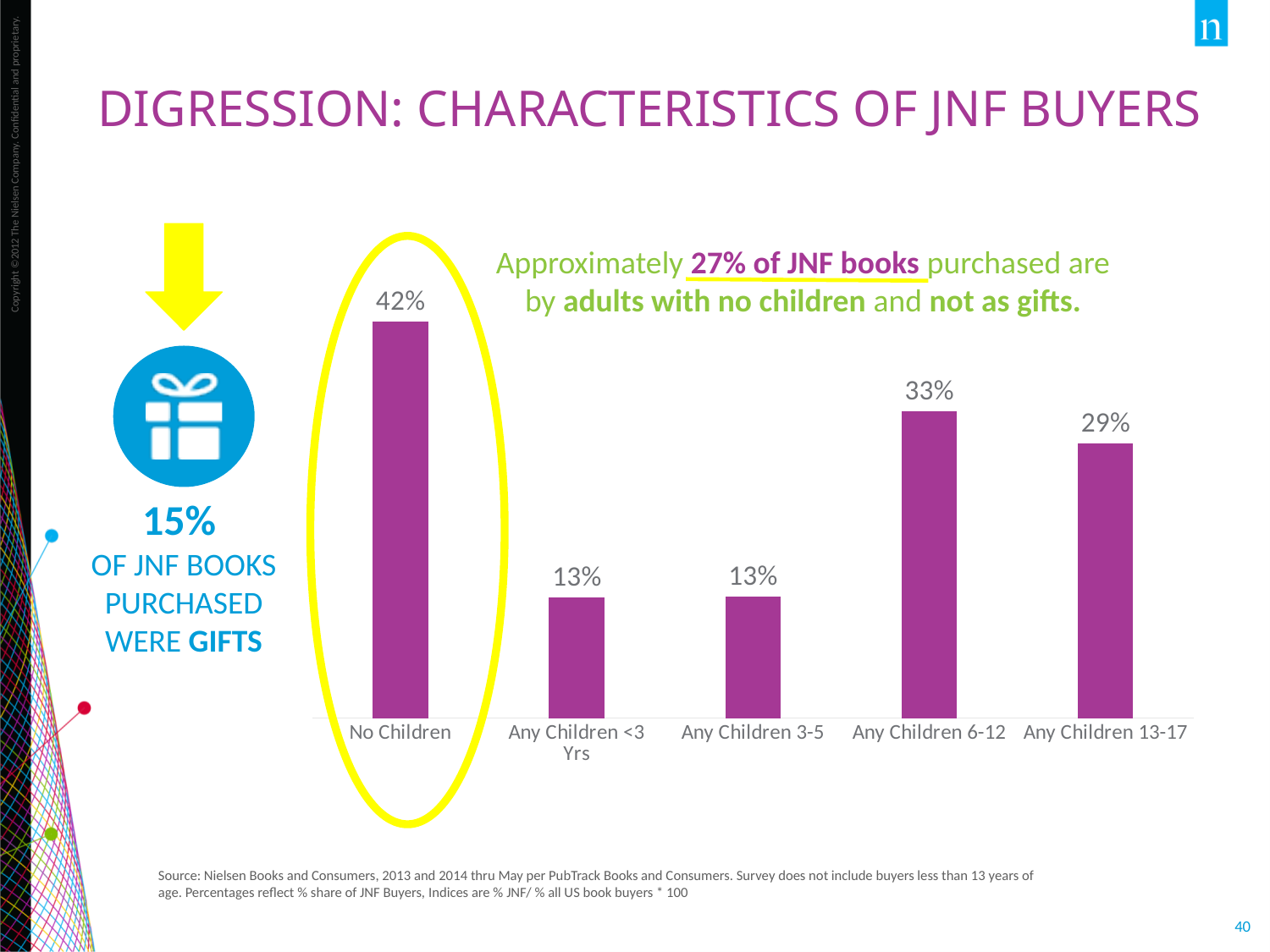
Which category has the highest value? No Children What is the difference between the values for Any Children 13-17 and Any Children <3 Yrs? 16% Which category is circled in yellow on the chart? No Children What kind of chart is shown on the slide? Bar chart What is the value for Any Children 6-12? 33% What is the value for No Children? 42% How many categories are shown in the chart? 5 Which two categories share the same value? Any Children <3 Yrs and Any Children 3-5 What is the difference between the values for No Children and Any Children 6-12? 9% What is the value for Any Children 13-17? 29% Which is larger, the value for Any Children 6-12 or Any Children 13-17? Any Children 6-12 What is the value for Any Children 3-5? 13%